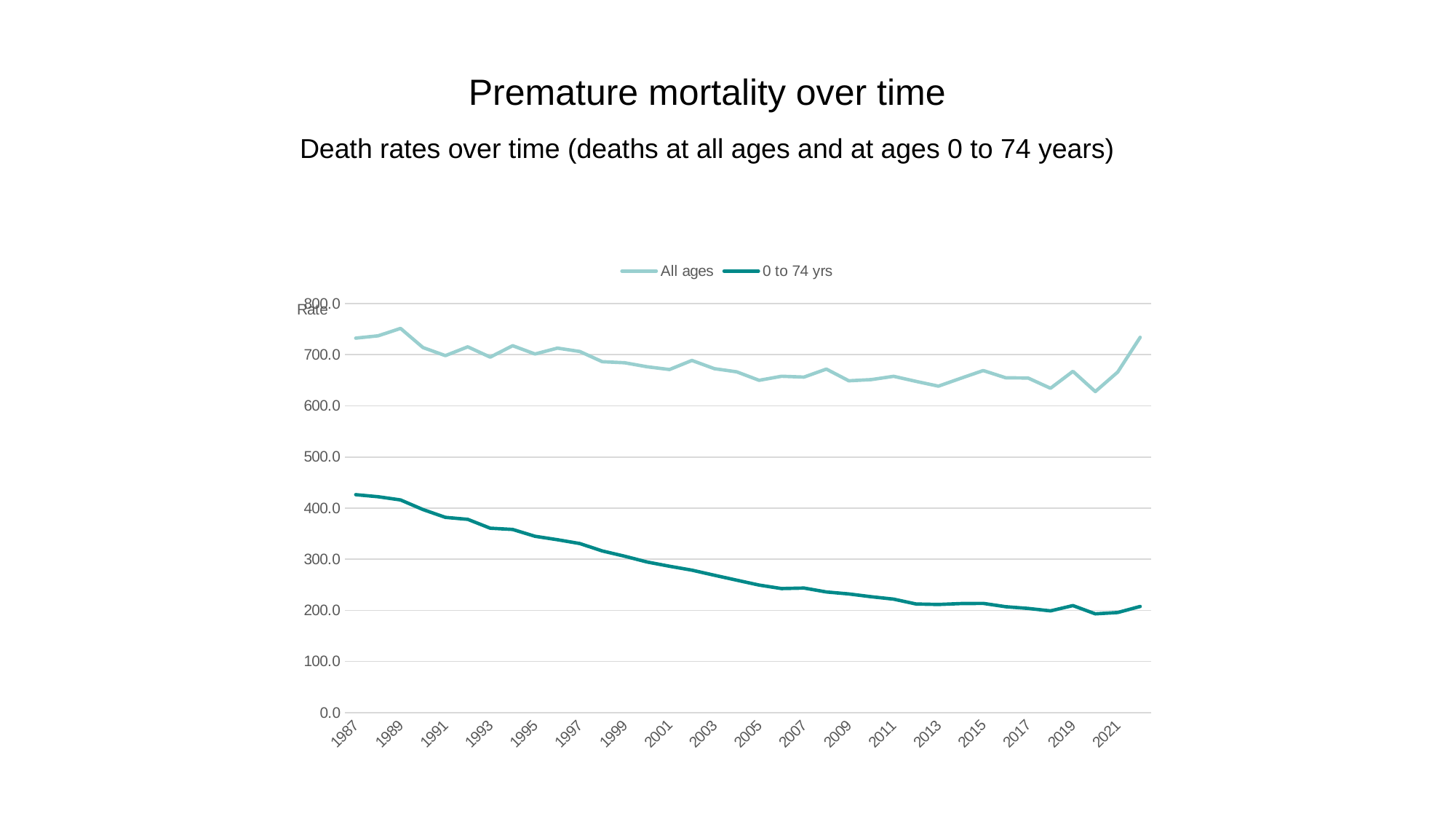
Is the value for All ages in 1987 greater or less than 700? greater In which year is the 0 to 74 yrs series at its highest? 1987 How many series does the legend list? 2 What are the two series named in the legend? All ages; 0 to 74 yrs What is the title of the chart? Death rates over time (deaths at all ages and at ages 0 to 74 years) Is the value for 0 to 74 yrs in 2013 greater or less than 300? less Is the value for All ages in 2021 greater or less than 700? less Does the 0 to 74 yrs series generally rise or fall from 1987 to 2021? fall In 2001, which series has the larger value, All ages or 0 to 74 yrs? All ages What kind of chart is shown on the slide? line chart